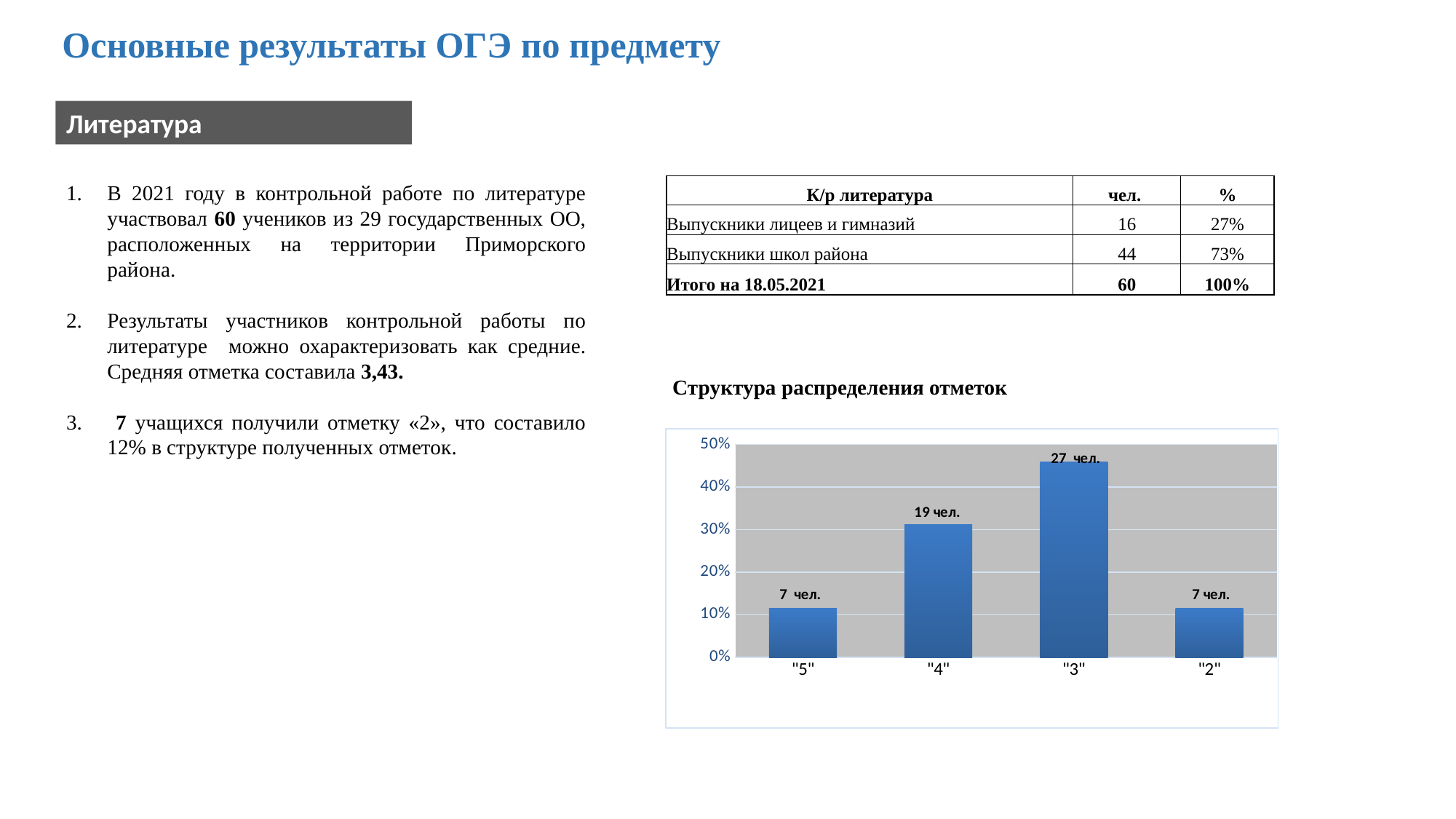
Is the value for "5" greater or less than 20%? less What is the data label on the bar for "3"? 27 чел. Which grade category has the highest bar? "3" Which bar is taller, "4" or "3"? "3" What is the data label on the bar for "2"? 7 чел. Is the value for "4" greater or less than 40%? less Is the value for "3" greater or less than 40%? greater What kind of chart is used to show the distribution of grades? bar chart What is the data label on the bar for "4"? 19 чел. What is the title of the chart? Структура распределения отметок How many grade categories are shown on the x axis of the chart? 4 By how many people does the "3" bar exceed the "4" bar, according to the data labels? 8 чел.